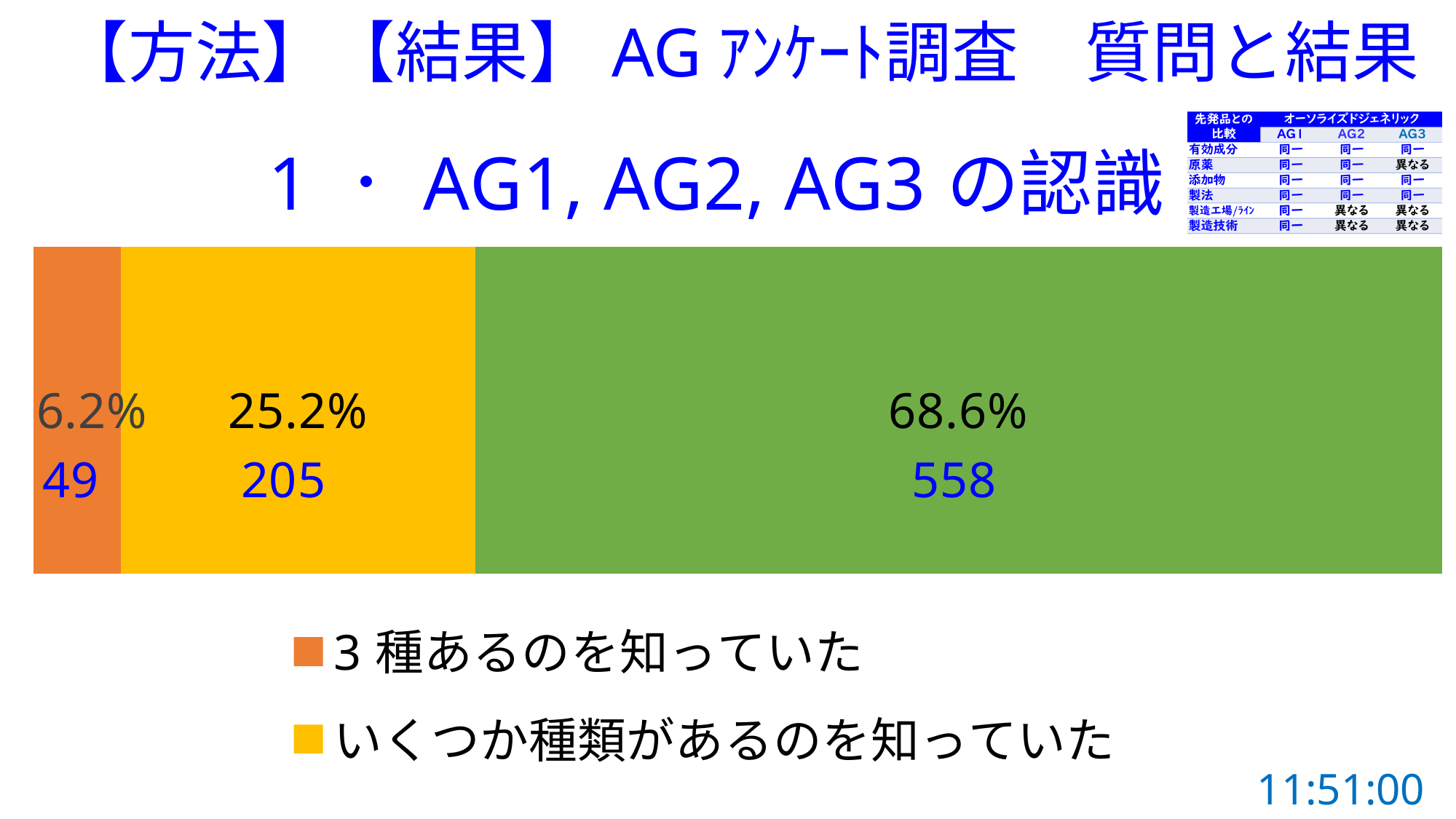
What is the difference in percentage points between the green segment (68.6%) and the yellow segment (25.2%)? 43.4 How many segments does the stacked bar have? 3 What kind of chart is shown on the slide? Stacked bar chart What is the difference in count between いくつか種類があるのを知っていた (205) and ３種あるのを知っていた (49)? 156 What colour is the segment for ３種あるのを知っていた? Orange What is the total count across all three segments of the bar? 812 What percentage is shown for the segment labelled ３種あるのを知っていた? 6.2% What count is shown on the green segment of the bar? 558 Which of the two legend categories, ３種あるのを知っていた or いくつか種類があるのを知っていた, has the larger value? いくつか種類があるのを知っていた What percentage is shown on the green segment of the bar? 68.6% Which segment of the bar has the smallest value? ３種あるのを知っていた What count is shown for the segment labelled いくつか種類があるのを知っていた? 205